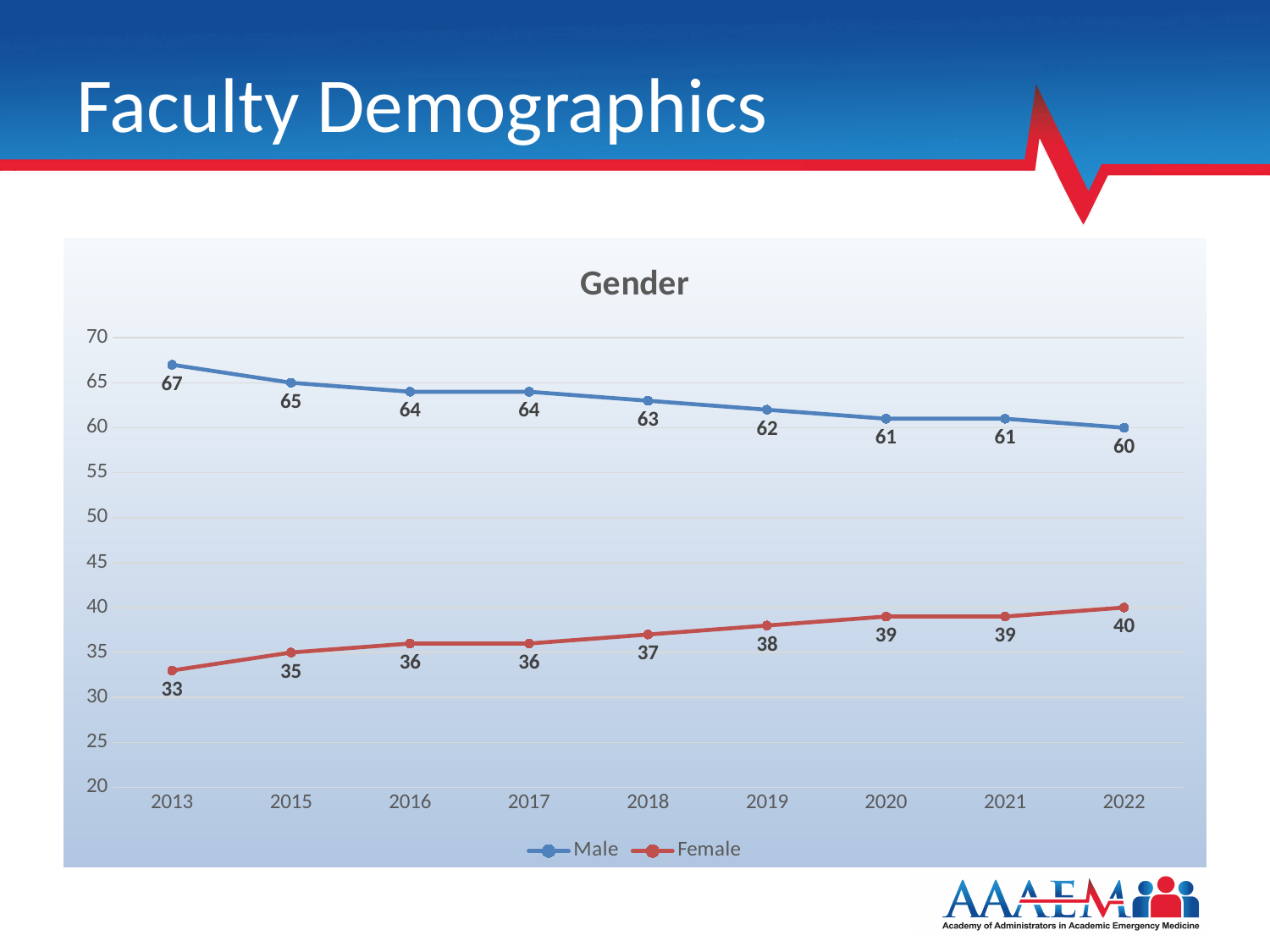
Does the Male series rise or fall from 2013 to 2022? Fall In which year is the Male series at its lowest? 2022 What is the Female value for 2022? 40 Which is larger in 2019, the Male value or the Female value? Male In which year is the Female series at its highest? 2022 What is the difference between the Male and Female values in 2013? 34 How many years are shown on the x axis? 9 What is the Female value for 2018? 37 What is the Male value for 2013? 67 How many series does the legend list? 2 What kind of chart is shown? Line chart What is the difference between the Male and Female values in 2022? 20